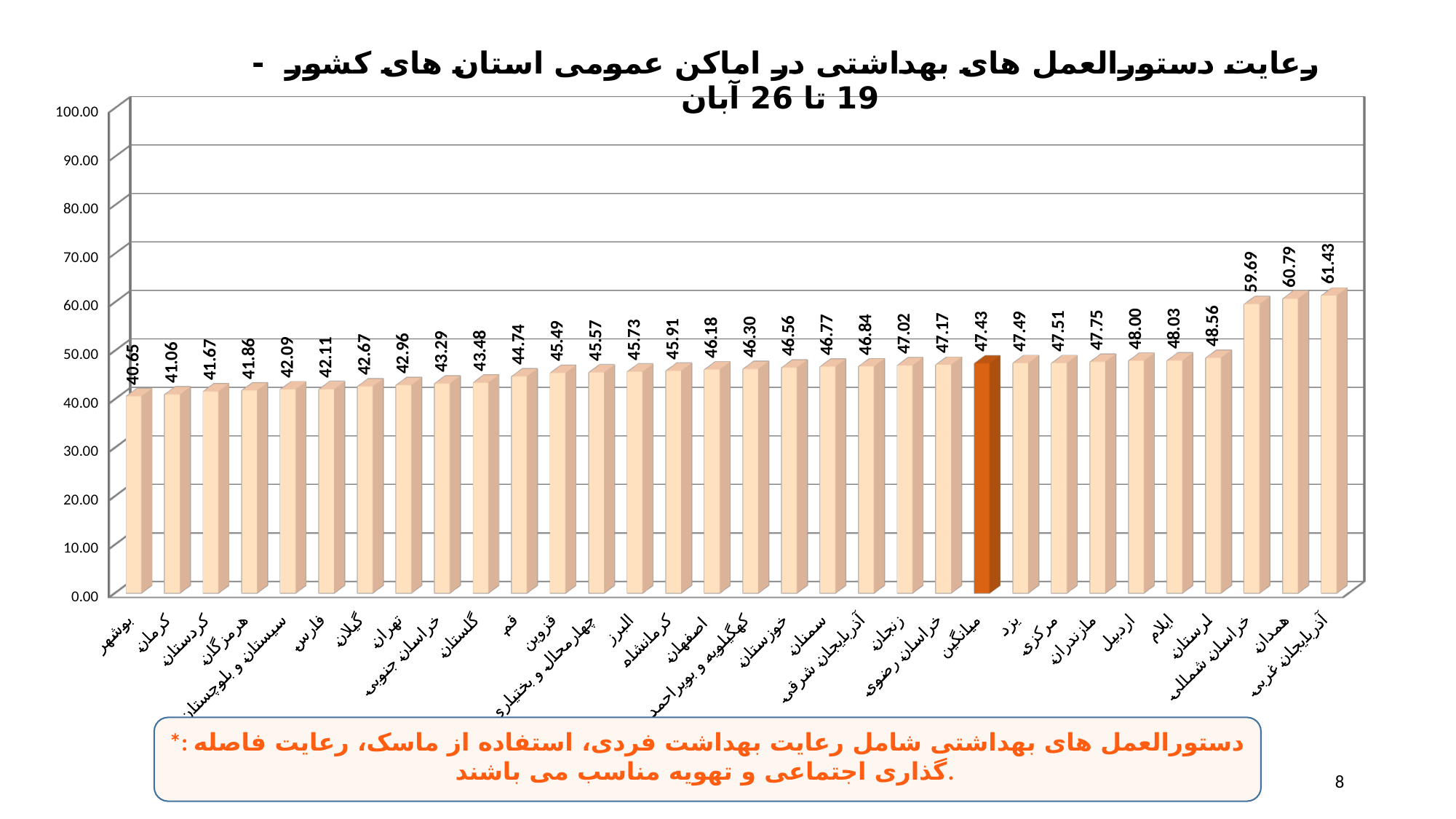
Which is larger, the value for قم or the value for اصفهان? اصفهان What is the difference between the values for آذربایجان غربی and بوشهر? 20.78 Is the value for خراسان شمالی greater or less than 50.00? greater What is the value for همدان? 60.79 What is the value for تهران? 42.96 Which category has the lowest value? بوشهر Which category has the highest value? آذربایجان غربی Do the values rise or fall from left to right along the x axis? rise What kind of chart is shown on the slide? bar chart What is the value for میانگین (the highlighted bar)? 47.43 How many bars are plotted in the chart? 32 What is the difference between the values for لرستان and خراسان شمالی? 11.13